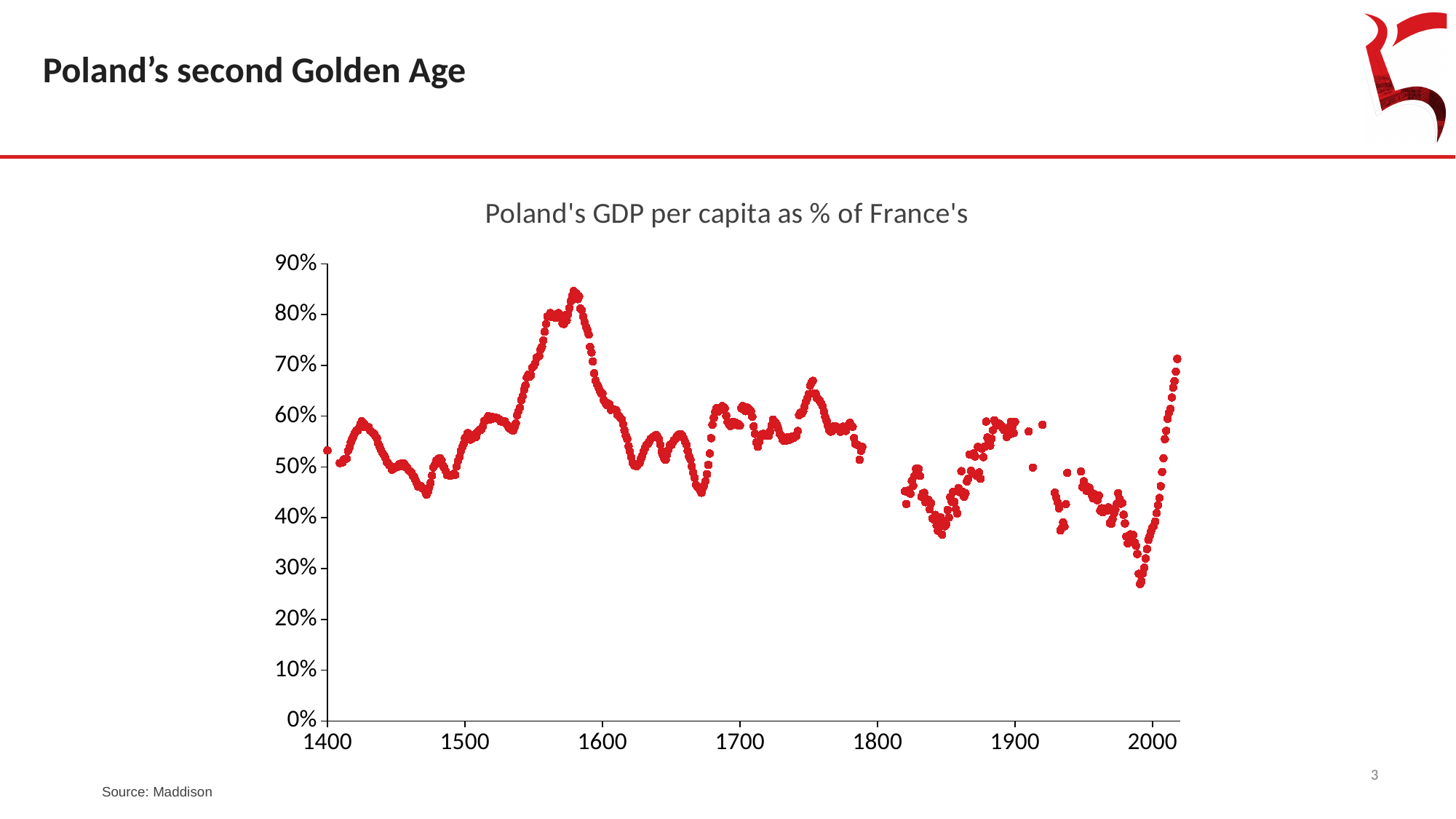
What is the title of the chart? Poland's GDP per capita as % of France's Do the values rise or fall between 1990 and the end of the series? rise Around which year does the chart reach its lowest value? around 1990 Is the value around 1850 greater or less than 50%? less What source is cited for the chart's data? Maddison In which century does the chart reach its highest value? the 1500s (around 1580) Is the most recent value (around 2018) greater or less than 60%? greater Do the values rise or fall between 1580 and 1620? fall Is the peak value reached around 1580 greater or less than 80%? greater What kind of chart is shown on the slide? scatter chart